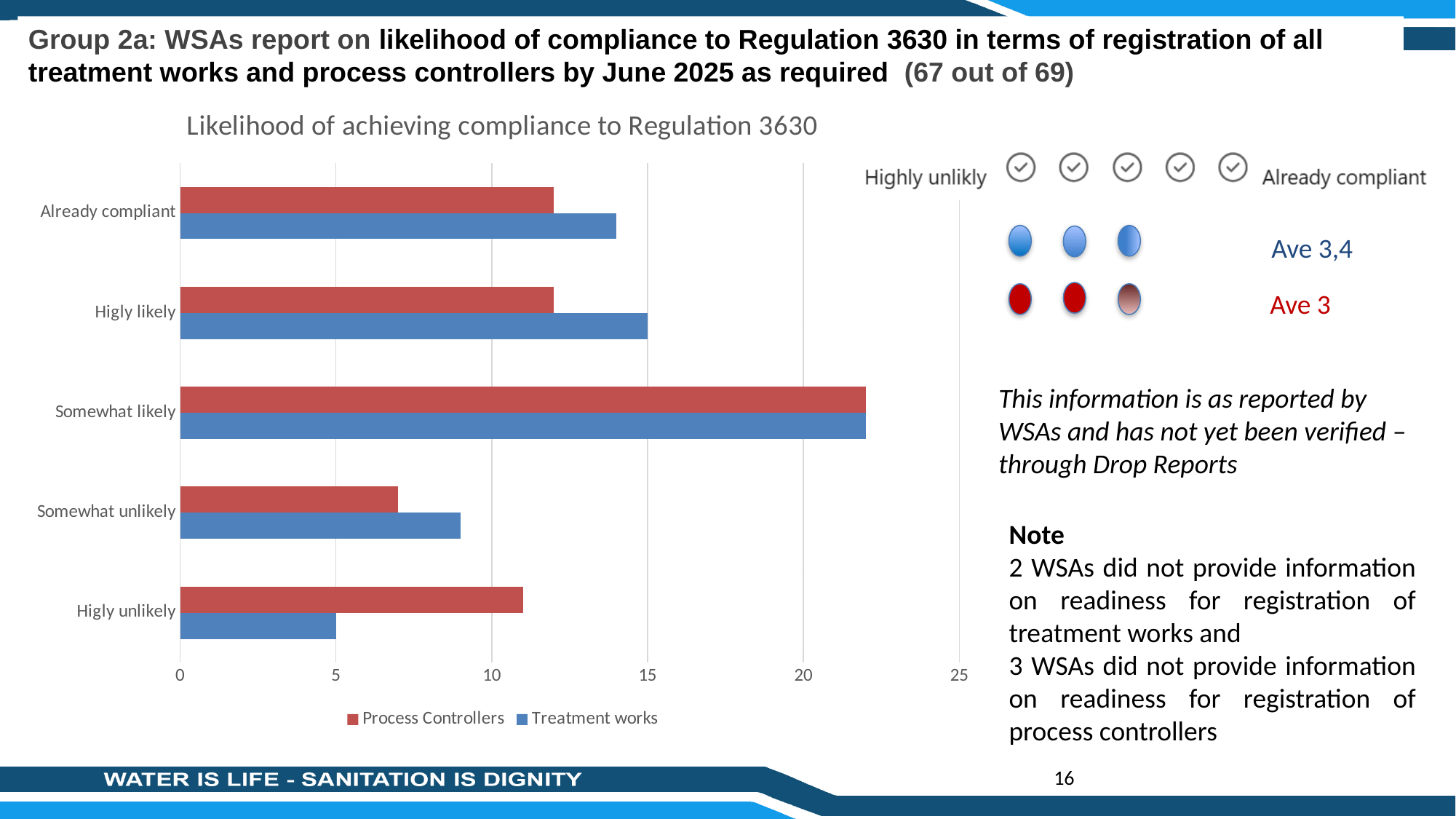
How many series does the chart legend list? 2 Is the Process Controllers value for Somewhat likely greater or less than 20? greater Which category has the highest Process Controllers value? Somewhat likely Which category has the lowest Process Controllers value? Somewhat unlikely What kind of chart is shown on the slide? bar chart What is the title of the chart? Likelihood of achieving compliance to Regulation 3630 Is the Treatment works value for Somewhat unlikely greater or less than 10? less Which category has the lowest Treatment works value? Higly unlikely What is the Treatment works value for Higly likely? 15 What is the Treatment works value for Higly unlikely? 5 How many categories are shown on the chart's vertical axis? 5 For Higly unlikely, which series has the larger value, Process Controllers or Treatment works? Process Controllers